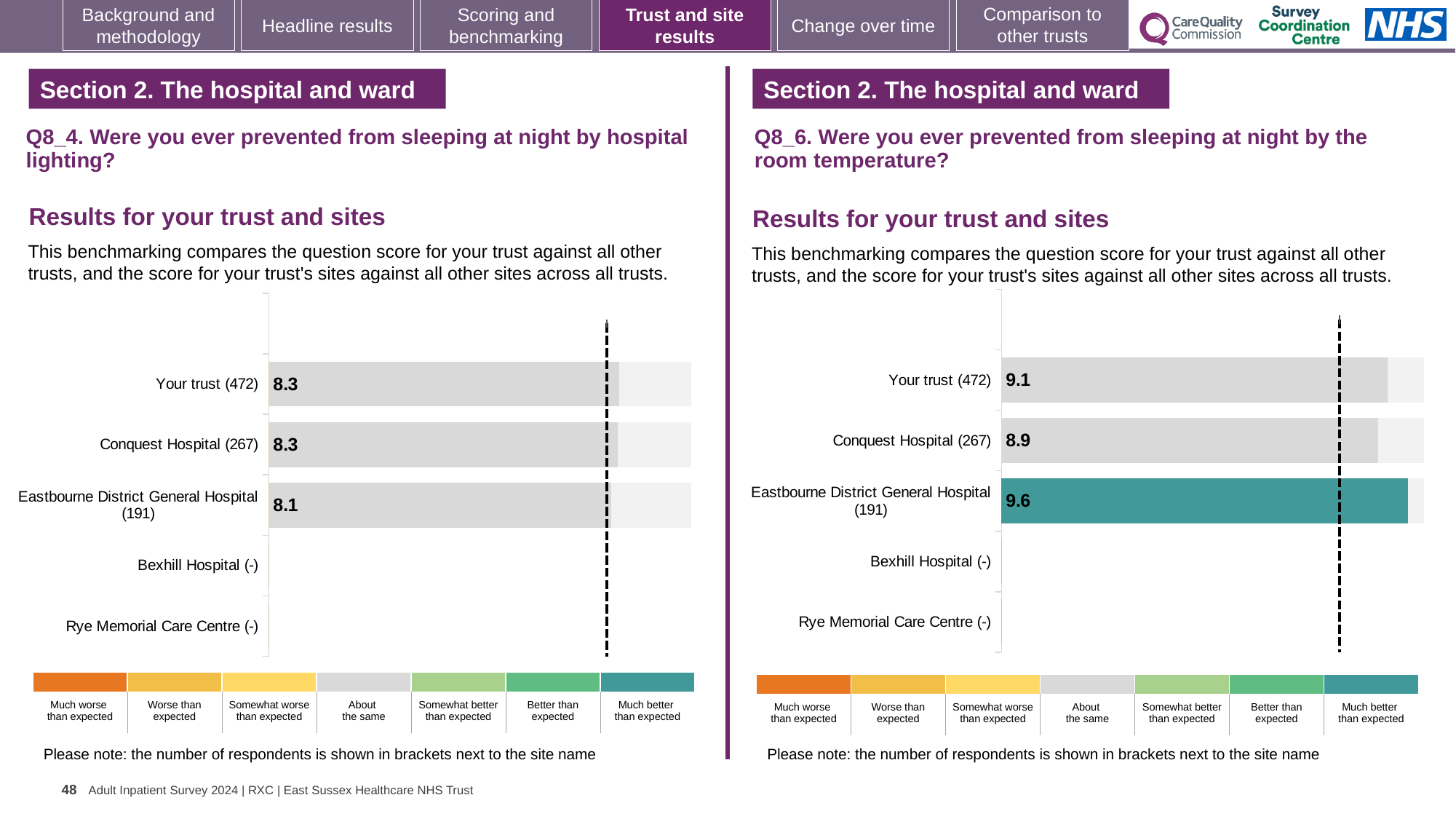
On the Q8_4 chart (hospital lighting), what is the score for Eastbourne District General Hospital (191)? 8.1 On the Q8_6 chart (room temperature), which benchmark category does the colour of the Eastbourne District General Hospital bar correspond to? Much better than expected On the Q8_4 chart (hospital lighting), what is the score for Your trust (472)? 8.3 How many site or trust rows are listed on the Q8_4 chart (hospital lighting)? 5 On the Q8_6 chart (room temperature), what is the score for Conquest Hospital (267)? 8.9 On the Q8_4 chart (hospital lighting), which of the three scored rows has the lowest score? Eastbourne District General Hospital (191) On the Q8_4 chart (hospital lighting), what is the difference between the scores for Your trust and Eastbourne District General Hospital? 0.2 On the Q8_6 chart (room temperature), what is the score for Eastbourne District General Hospital (191)? 9.6 On the Q8_6 chart (room temperature), what is the difference between the scores for Eastbourne District General Hospital and Conquest Hospital? 0.7 On the Q8_6 chart (room temperature), which has the larger score, Your trust (472) or Conquest Hospital (267)? Your trust (472) What type of chart is used for the Q8_6 results (room temperature)? Bar chart On the Q8_6 chart (room temperature), which site or trust has the highest score? Eastbourne District General Hospital (191)